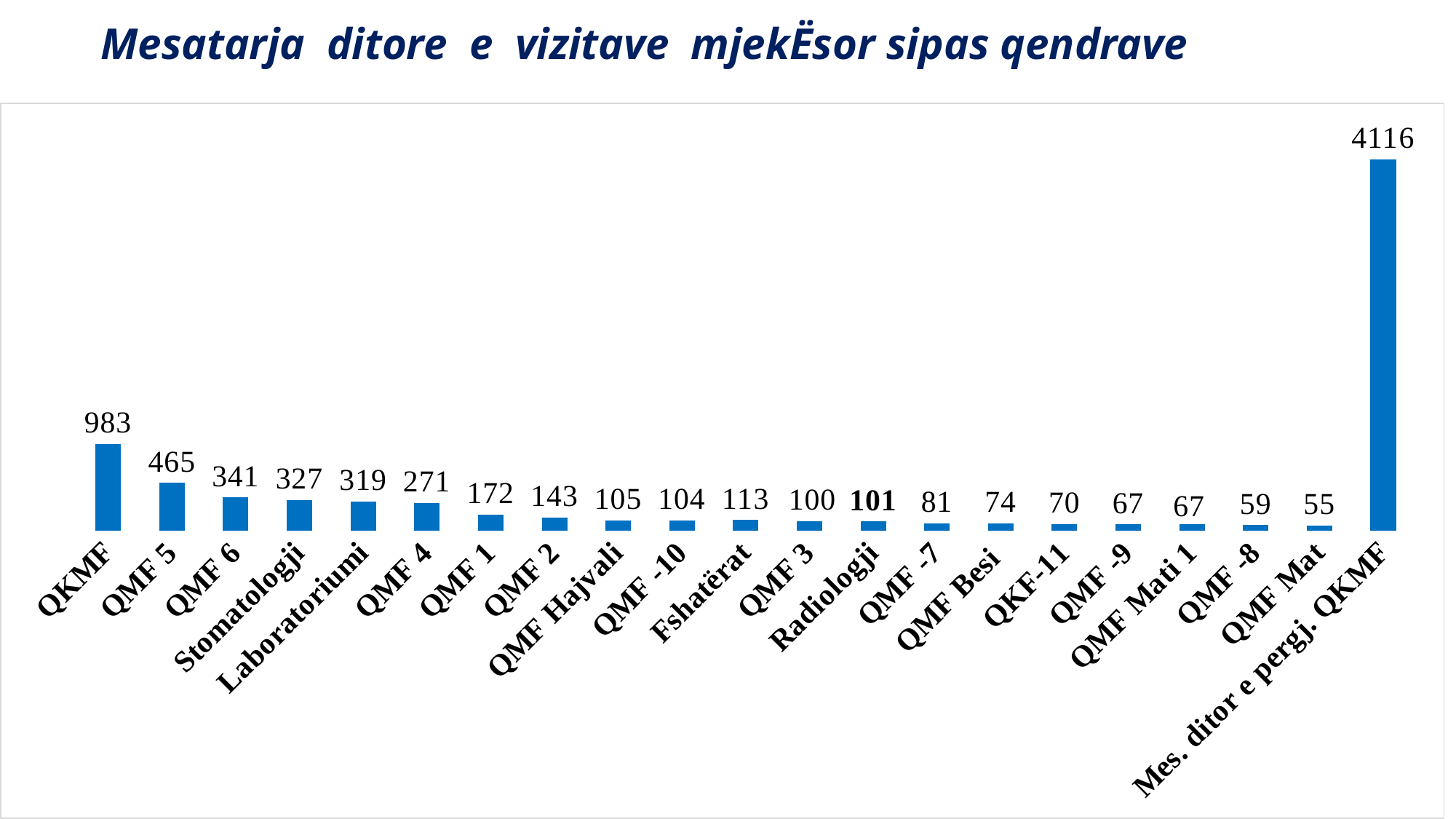
What is the value for QKMF? 983 Which category has the lowest value? QMF Mat What is the value for QMF Hajvali? 105 What kind of chart is this? Bar chart What is the difference between the values for QMF 5 and QMF 6? 124 Which category has the highest value? Mes. ditor e pergj. QKMF What is the value for Stomatologji? 327 What is the value for Mes. ditor e pergj. QKMF? 4116 Which is larger, the value for Fshatërat or the value for QMF 3? Fshatërat What is the difference between the values for QKMF and QMF 5? 518 How many categories are shown on the x axis? 21 What is the title of the chart? Mesatarja ditore e vizitave mjekËsor sipas qendrave